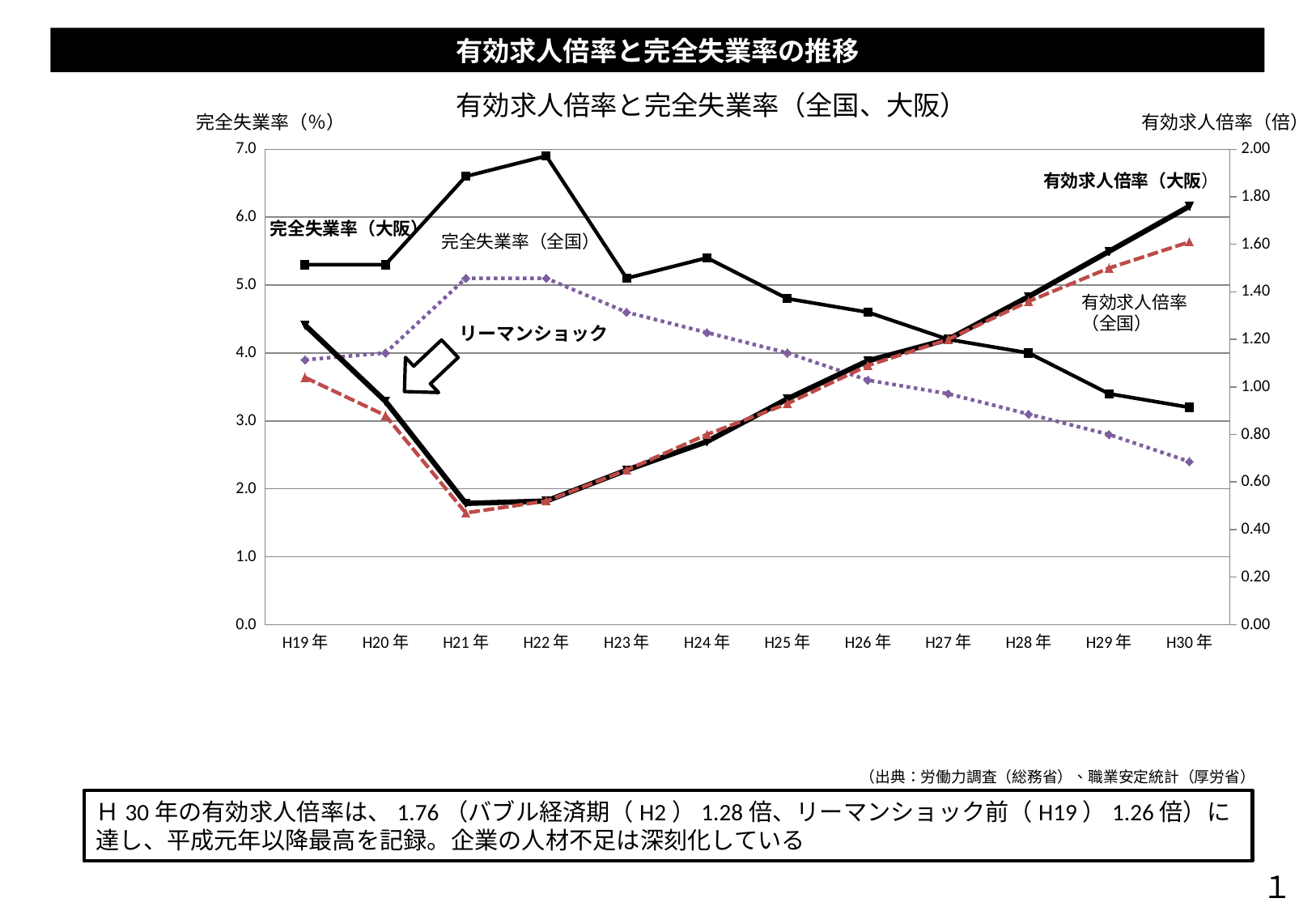
In H30年, which is higher: 有効求人倍率（大阪） or 有効求人倍率（全国）? 有効求人倍率（大阪） Does 完全失業率（全国） rise or fall from H22年 to H30年? fall Does 有効求人倍率（大阪） rise or fall from H21年 to H30年? rise In which year is 有効求人倍率（大阪） at its lowest? H21年 Is the value for 完全失業率（全国） in H30年 greater or less than 3.0? less How many data series are plotted on the chart? 4 Is the value for 完全失業率（大阪） in H19年 greater or less than 5.0? greater In which year is 完全失業率（大阪） at its highest? H22年 What kind of chart is shown on the slide? line chart Is the value for 有効求人倍率（大阪） in H30年 greater or less than 1.60? greater How many years are shown along the x axis of the chart? 12 What is the title of the chart? 有効求人倍率と完全失業率（全国、大阪）